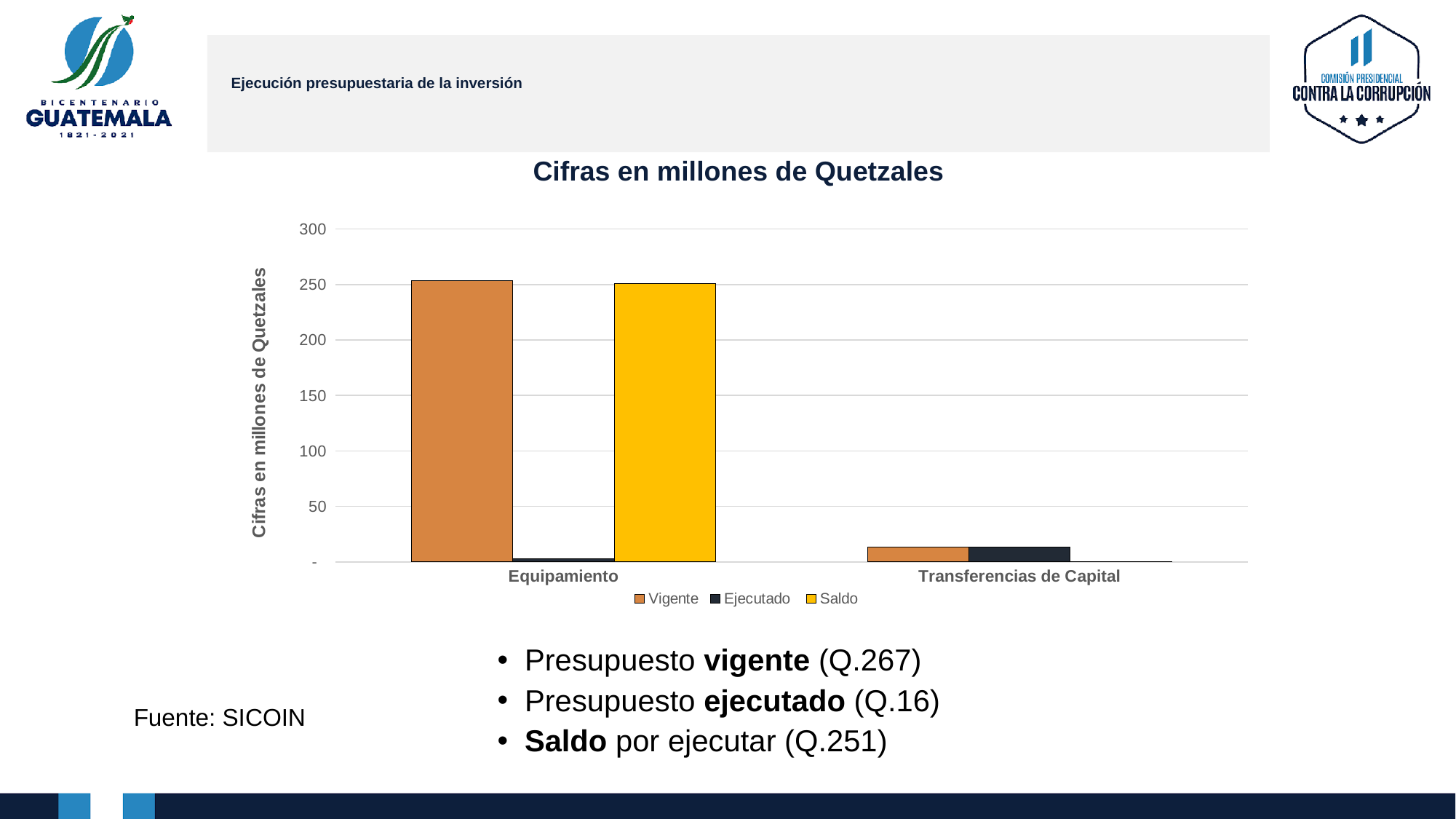
Which series is shown in yellow in the chart? Saldo Is the Vigente value for Equipamiento greater or less than 200? greater How many categories are shown on the x axis of the chart? 2 What is the title of the chart? Cifras en millones de Quetzales Is the Saldo value for Equipamiento greater or less than 300? less What kind of chart is shown on the slide? bar chart Which category has the tallest Vigente bar? Equipamiento Is the Ejecutado value for Equipamiento greater or less than 50? less Which category has the lowest Saldo bar? Transferencias de Capital How many series does the chart's legend list? 3 Which is larger: the Vigente bar for Equipamiento or the Vigente bar for Transferencias de Capital? Equipamiento